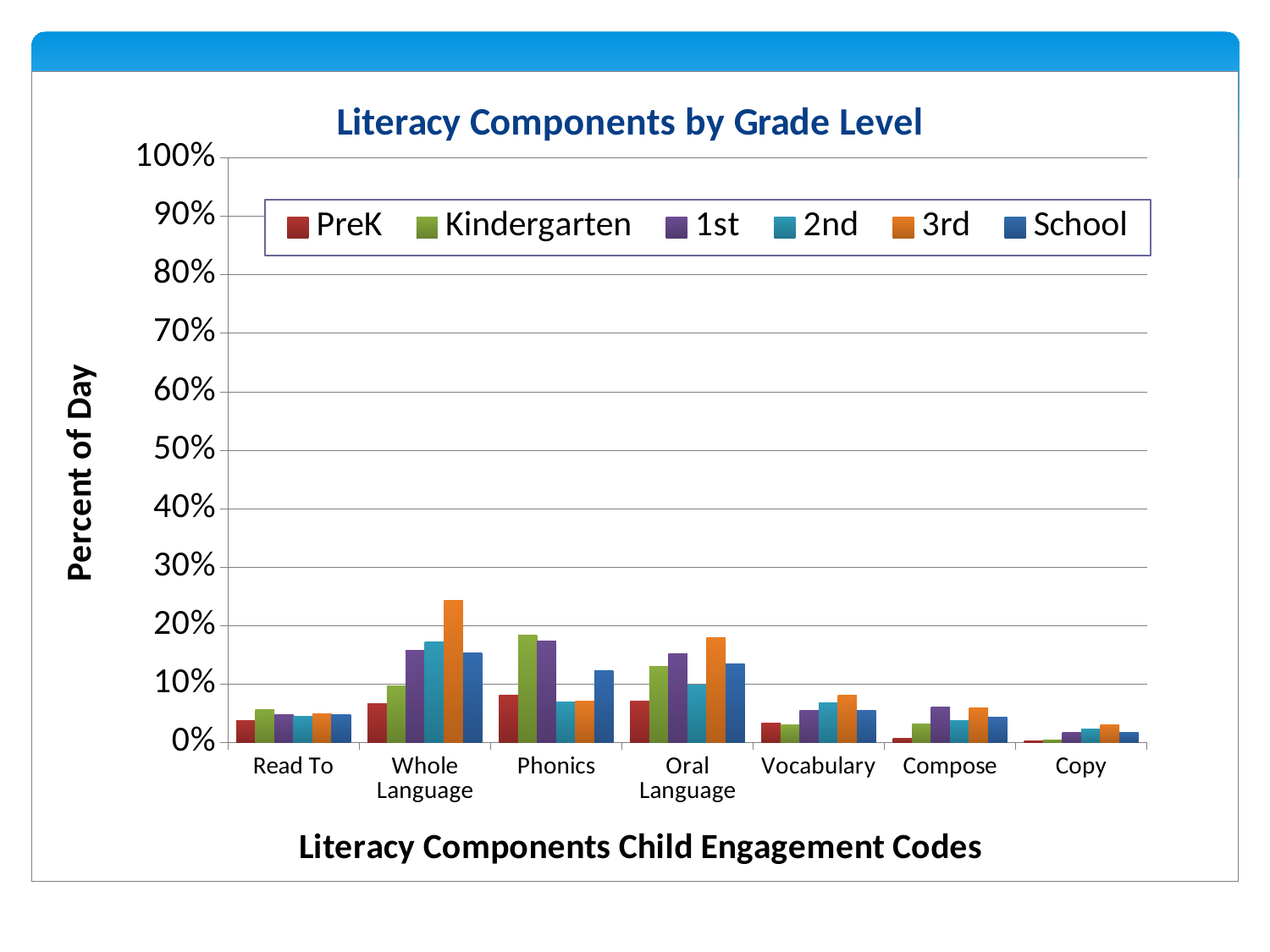
Is the Kindergarten value for Phonics greater or less than 10%? greater How many literacy component categories are shown on the x axis? 7 What kind of chart is shown on the slide? bar chart In which category is the 3rd grade bar the highest? Whole Language Is the 3rd grade value for Whole Language greater or less than 20%? greater Is the PreK value for Copy greater or less than 10%? less What is the title of the chart? Literacy Components by Grade Level How many series does the legend list? 6 For Phonics, which is larger: the Kindergarten value or the 2nd grade value? Kindergarten What is the label on the vertical axis? Percent of Day Which category has the lowest PreK value? Copy For Whole Language, which is larger: the 3rd grade value or the PreK value? 3rd